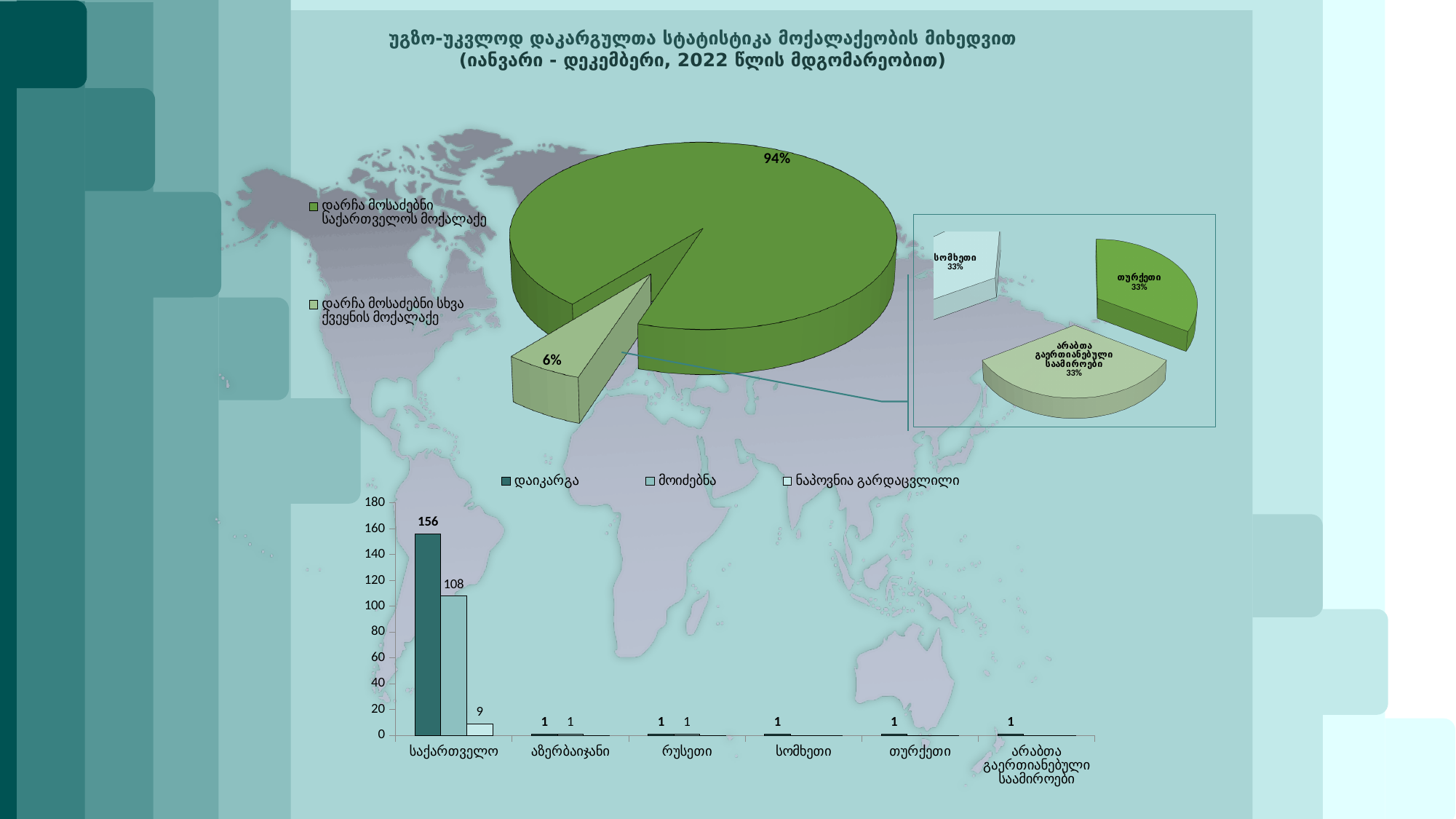
In the small pie chart on the right, what share is shown for თურქეთი? 33% In the bar chart, which category has the highest დაიკარგა value? საქართველო In the bar chart, what is the difference between დაიკარგა and მოიძებნა for საქართველო? 48 What kind of chart is the one at the bottom of the slide? bar chart In the bar chart, what is the value of მოიძებნა for საქართველო? 108 In the bar chart, what is the value of დაიკარგა for თურქეთი? 1 In the bar chart, what is the value of ნაპოვნია გარდაცვლილი for საქართველო? 9 How many series does the legend of the bar chart list? 3 In the bar chart, which is larger for საქართველო: მოიძებნა or ნაპოვნია გარდაცვლილი? მოიძებნა In the bar chart, what is the value of დაიკარგა for საქართველო? 156 In the large pie chart, what share is shown for დარჩა მოსაძებნი საქართველოს მოქალაქე? 94% How many categories are shown on the x axis of the bar chart? 6